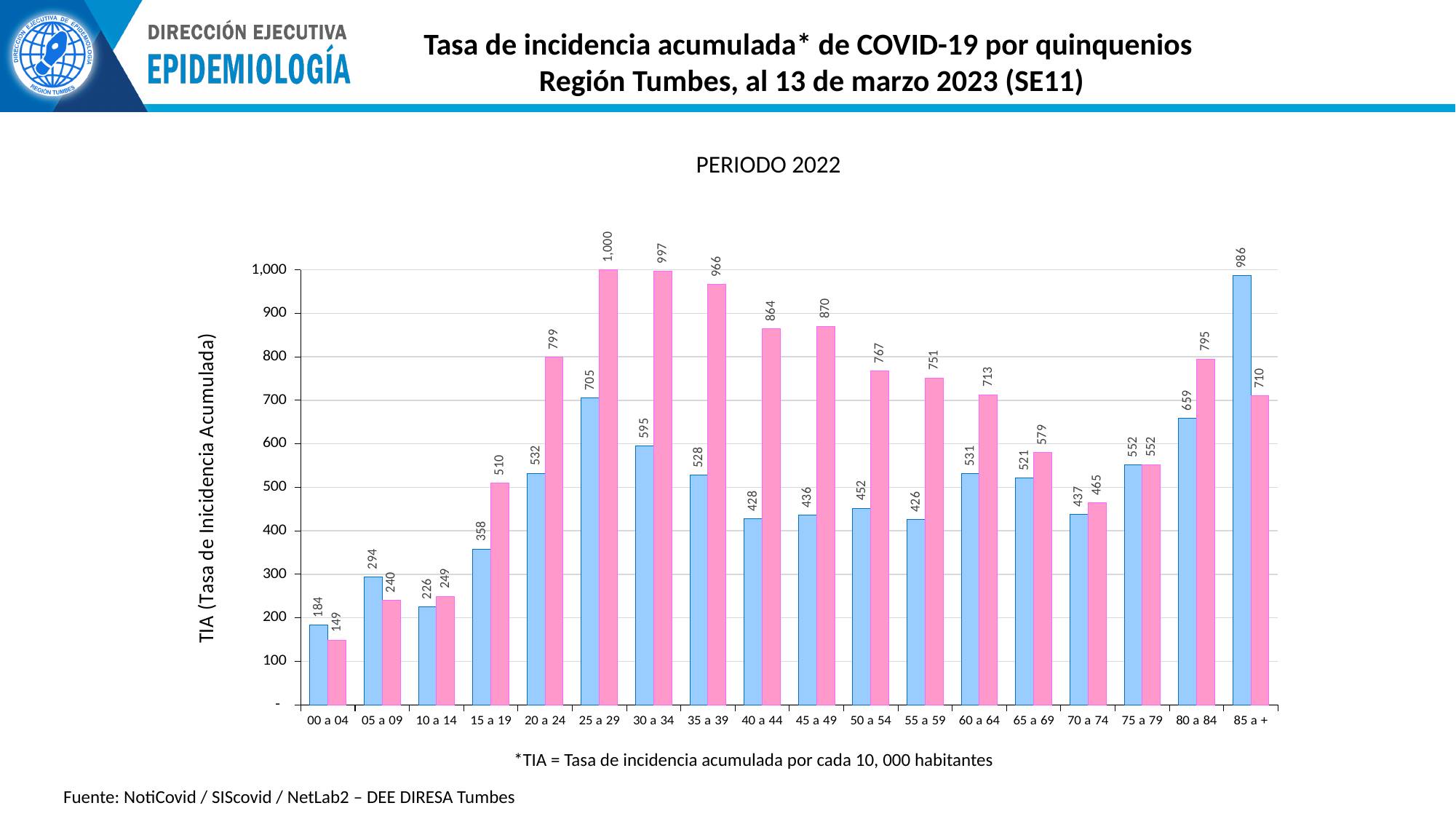
Which is larger for the 85 a + age group, the blue bar or the pink bar? the blue bar What kind of chart is shown on the slide? bar chart What is the value of the pink bar for the 40 a 44 age group? 864 What is the title shown above the chart? PERIODO 2022 How many age groups are shown on the x axis? 18 Which age group has the highest pink bar? 25 a 29 What is the value of the blue bar for the 25 a 29 age group? 705 Which age group has the highest blue bar? 85 a + What is the label of the y axis? TIA (Tasa de Incidencia Acumulada) What is the difference between the pink bar and the blue bar for the 30 a 34 age group? 402 Which age group has the lowest pink bar? 00 a 04 Is the value of the pink bar for the 20 a 24 age group greater or less than 700? greater